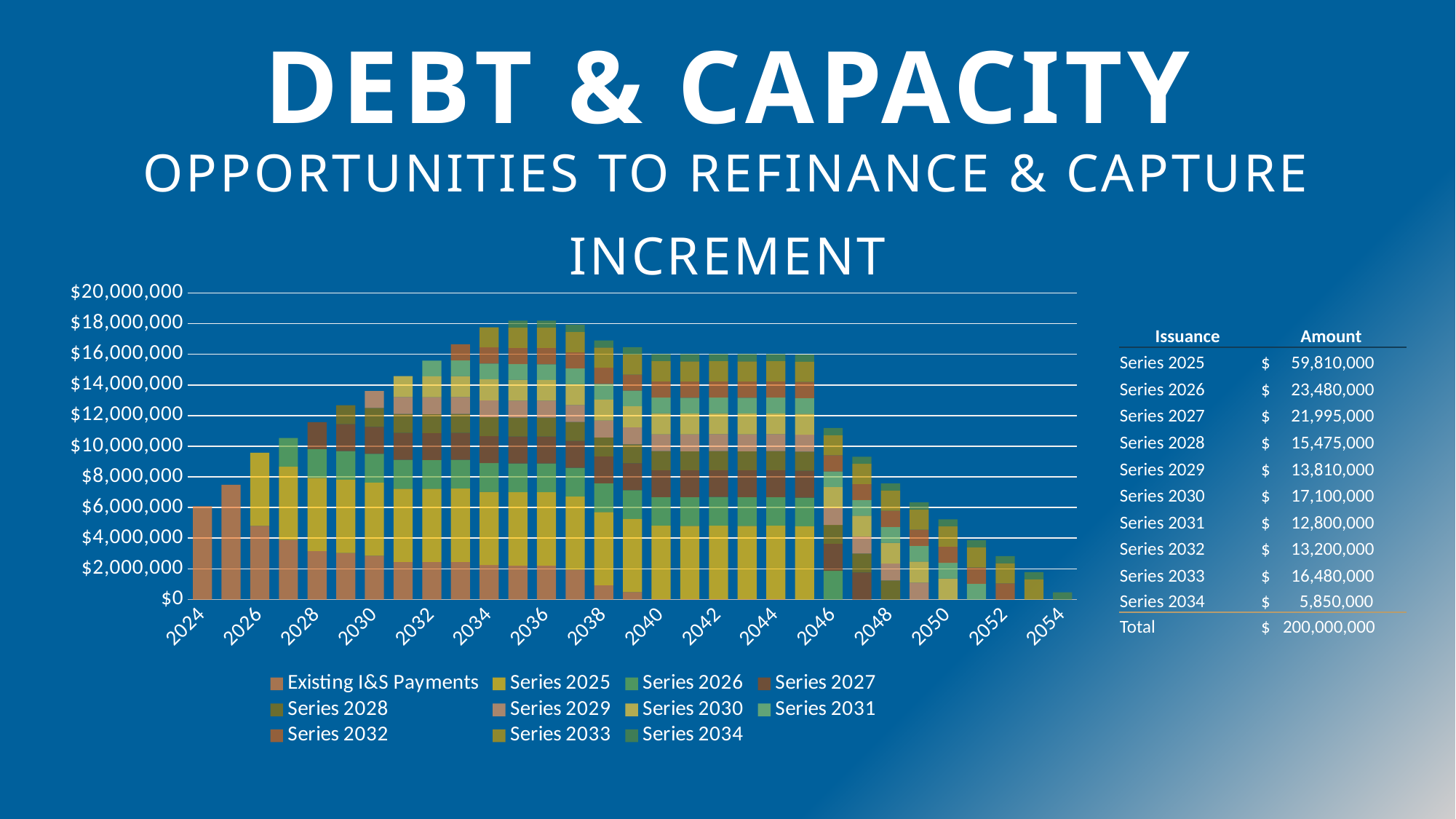
What kind of chart is shown on the slide? Stacked bar chart Is the total value of the bar for 2025 greater or less than $6,000,000? greater Which series is listed first in the chart legend? Existing I&S Payments How many series does the chart legend list? 11 Which year has the lowest total bar in the chart? 2054 Do the total bar values rise or fall from 2046 to 2054? fall Is the total value of the bar for 2046 greater or less than $10,000,000? greater Is the total value of the bar for 2040 greater or less than $14,000,000? greater Which year has the larger total bar, 2026 or 2050? 2026